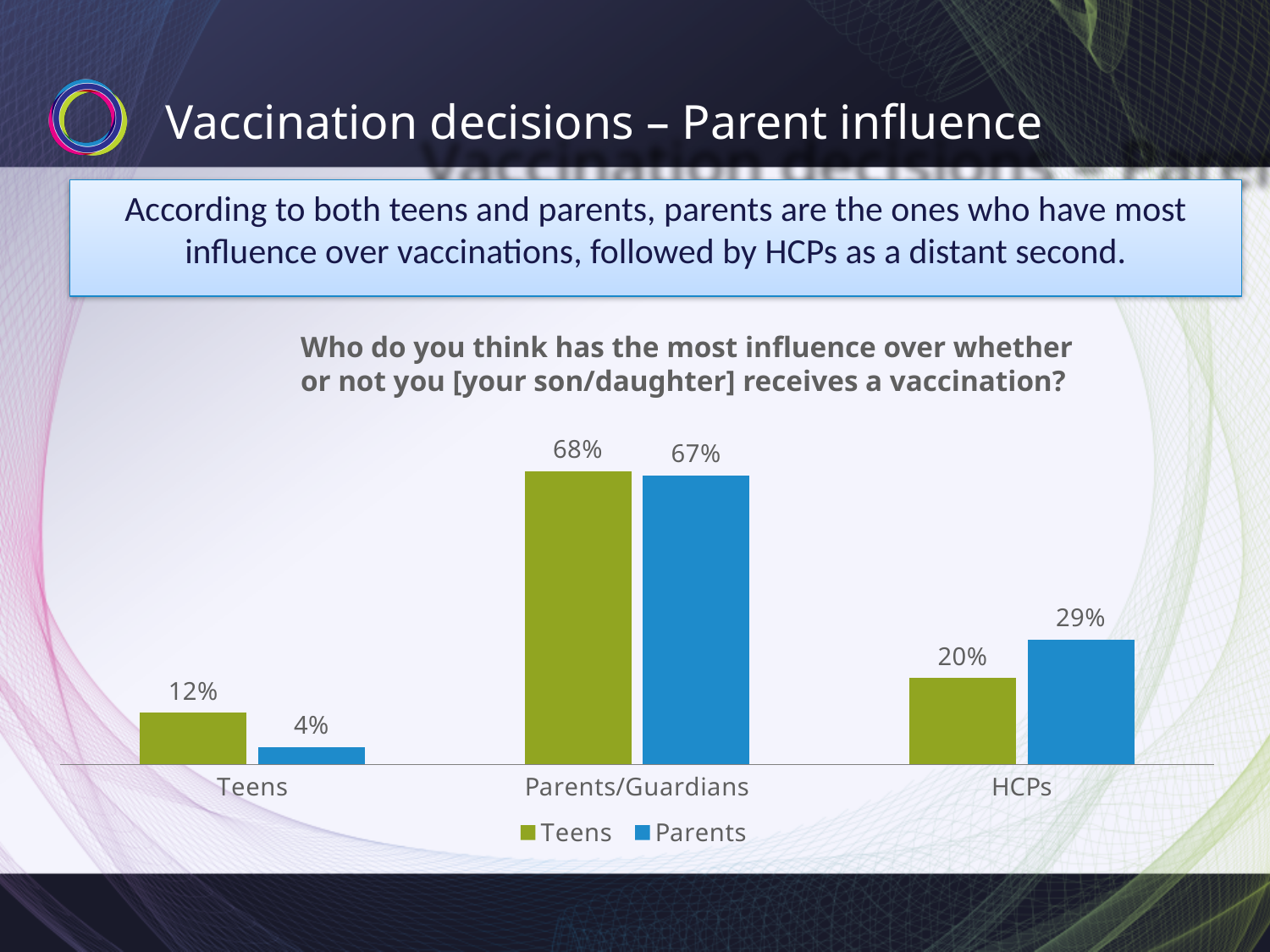
For HCPs, which series has the larger value, Teens or Parents? Parents Which series is shown in blue in the chart legend? Parents Which category has the lowest value for the Parents series? Teens How many series does the chart legend list? 2 What percentage of teens said Parents/Guardians have the most influence over vaccination? 68% What is the difference between the Parents and Teens values for HCPs? 9% Which category has the highest value for the Teens series? Parents/Guardians What is the difference between the Teens and Parents values for the Teens category? 8% What percentage of parents said Teens have the most influence over vaccination? 4% What percentage of parents said HCPs have the most influence over vaccination? 29% How many categories are shown on the x axis of the chart? 3 What kind of chart is shown on the slide? Bar chart